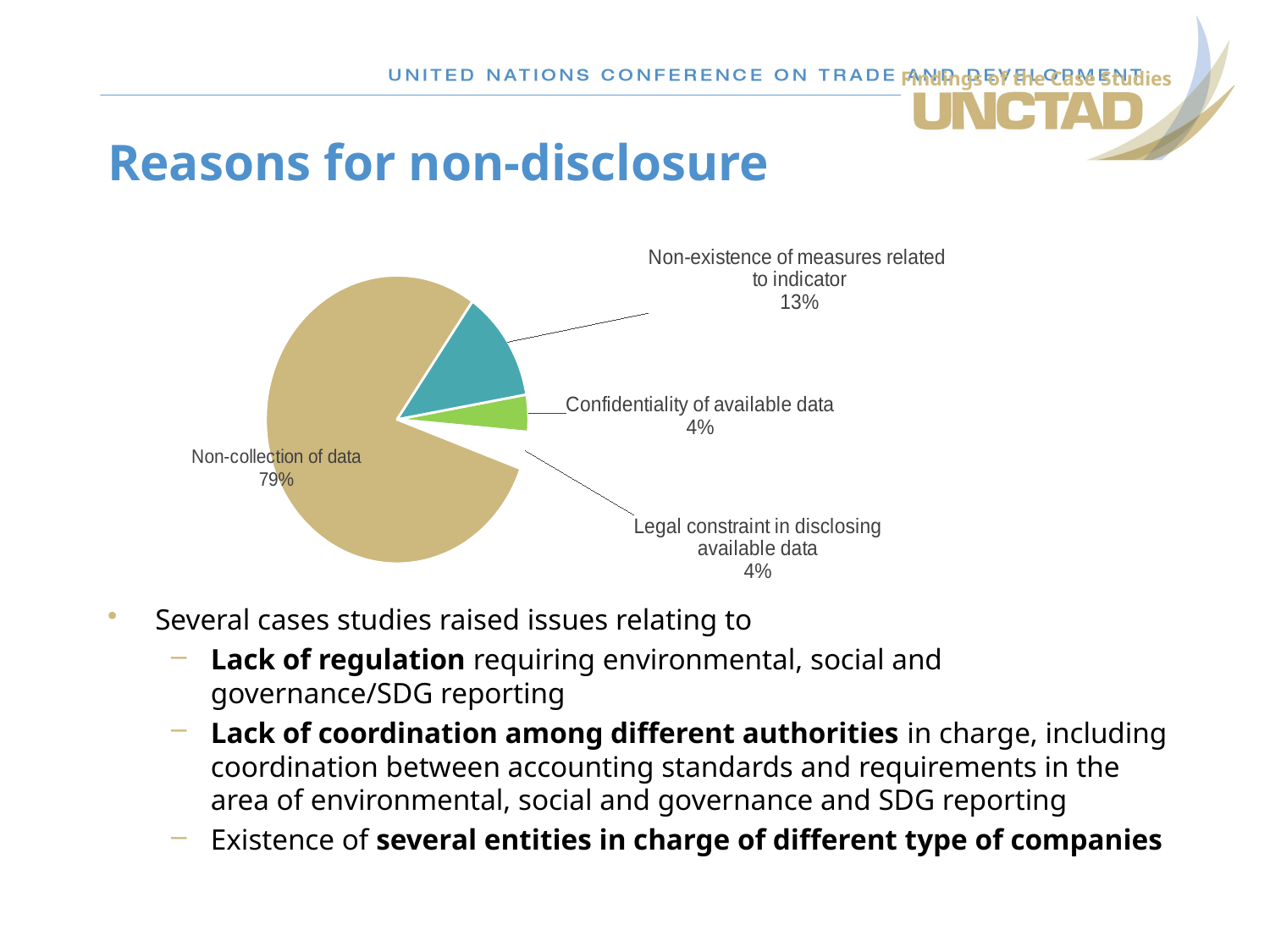
What share of the pie is Non-collection of data? 79% What is the title of the slide containing the pie chart? Reasons for non-disclosure How many slices does the pie chart have? 4 Which is larger: the share for Non-existence of measures related to indicator or the share for Confidentiality of available data? Non-existence of measures related to indicator What share of the pie is Legal constraint in disclosing available data? 4% What colour is the Non-collection of data slice? tan Which reason for non-disclosure has the largest share of the pie? Non-collection of data What share of the pie is Non-existence of measures related to indicator? 13% What kind of chart is shown on the slide? pie chart What is the difference in percentage points between Non-collection of data and Non-existence of measures related to indicator? 66 What is the difference in percentage points between Non-existence of measures related to indicator and Legal constraint in disclosing available data? 9